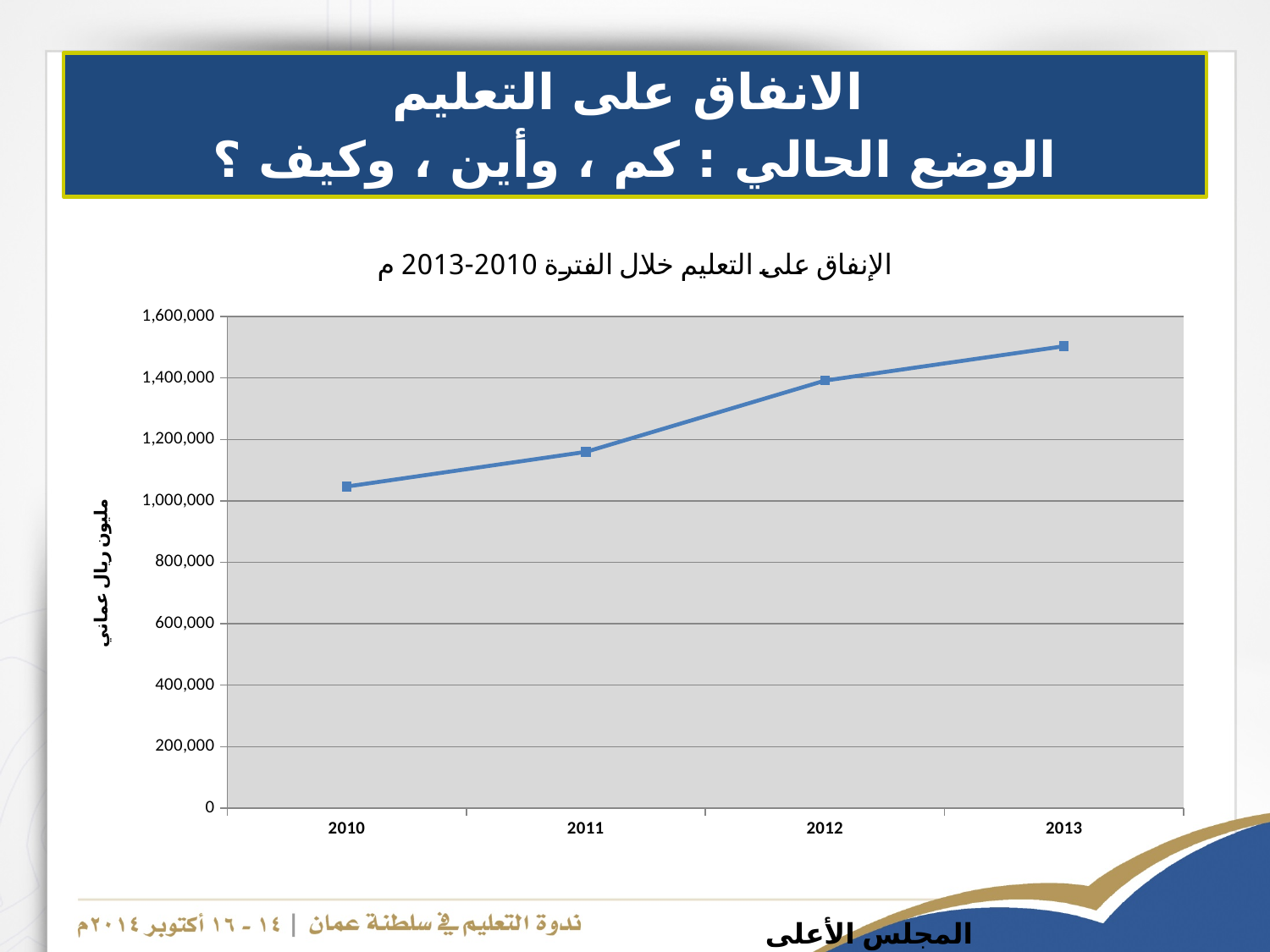
What is the title of the chart? الإنفاق على التعليم خلال الفترة 2010-2013 م Which year has the lowest value in the chart? 2010 Is the value for 2013 greater or less than 1,400,000? greater Which year has the larger value, 2011 or 2012? 2012 Is the value for 2010 greater or less than 1,000,000? greater Is the value for 2012 greater or less than 1,200,000? greater How many years are plotted on the x axis of the chart? 4 Which year has the highest value in the chart? 2013 Do the values in the chart rise or fall from 2010 to 2013? rise What kind of chart is shown on the slide? line chart What is the label on the vertical axis of the chart? مليون ريال عماني